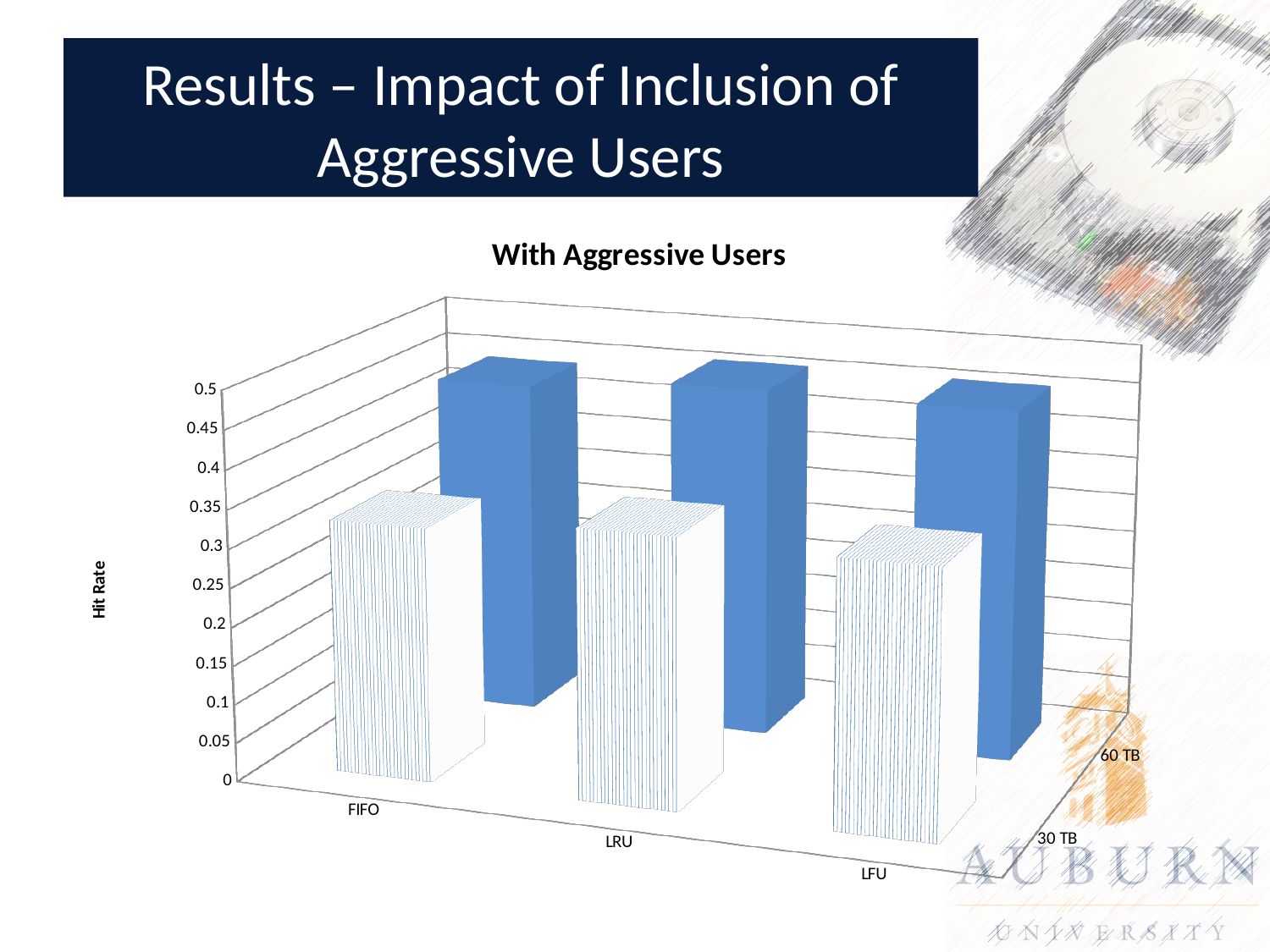
For FIFO, which series has the higher hit rate, 30 TB or 60 TB? 60 TB What is the title of the chart? With Aggressive Users Is the 30 TB hit rate for FIFO greater or less than 0.4? less How many storage-size series (30 TB, 60 TB) does the chart plot? 2 Is the 60 TB hit rate for FIFO greater or less than 0.3? greater For LFU, which series has the higher hit rate, 30 TB or 60 TB? 60 TB What kind of chart is shown on the slide? bar chart What is the label of the vertical axis? Hit Rate Is the 30 TB hit rate for LFU greater or less than 0.2? greater How many cache policies (categories) are shown along the x axis? 3